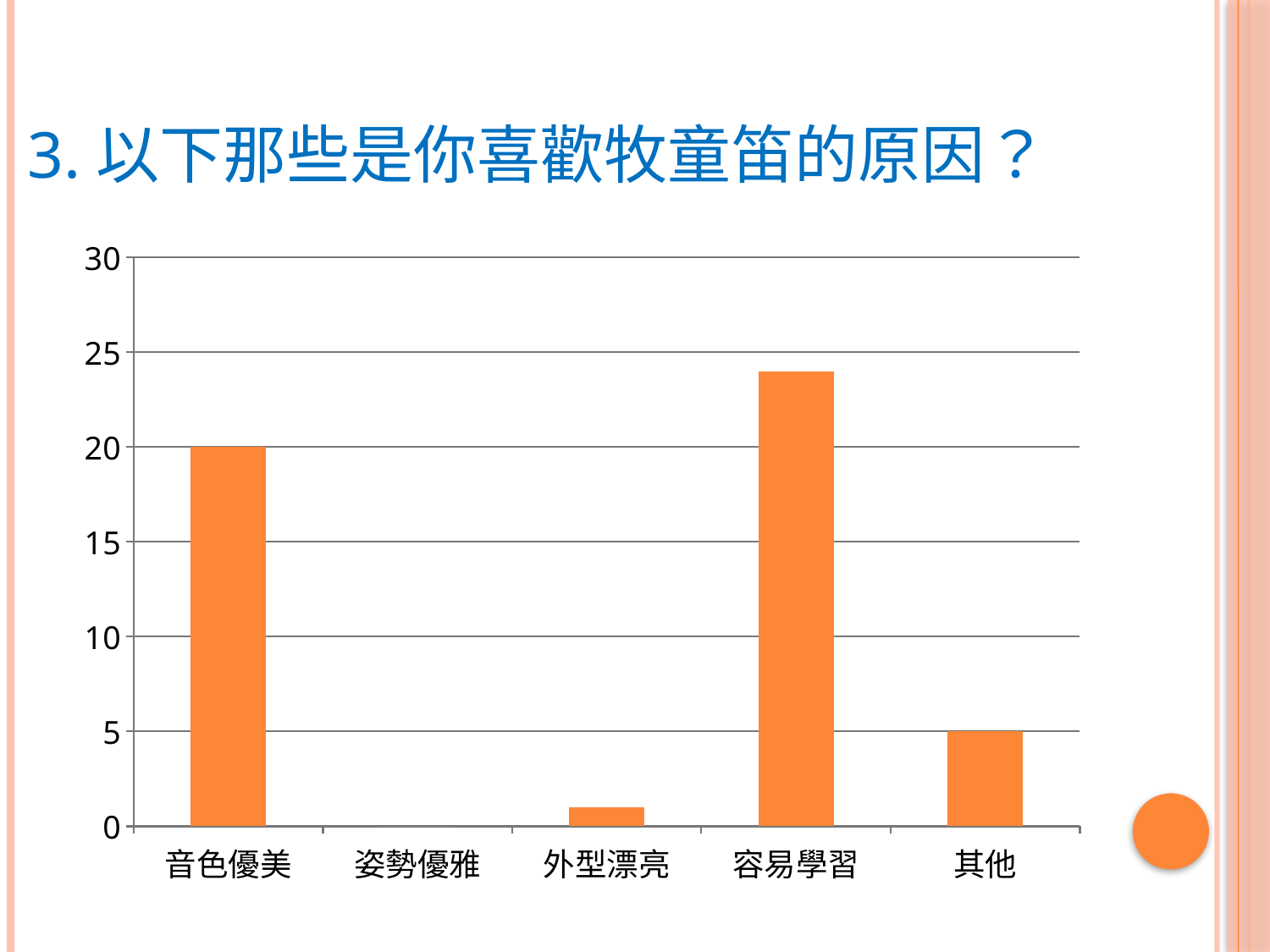
Which category has the highest value? 容易學習 Is the value for 外型漂亮 greater or less than 5? less Is the value for 容易學習 greater or less than 25? less What is the value for 音色優美? 20 Which category has the lowest value? 姿勢優雅 What is the difference between the values for 音色優美 and 其他? 15 How many categories are shown on the x axis? 5 Which is larger, the value for 音色優美 or the value for 其他? 音色優美 What is the value for 其他? 5 What is the value for 姿勢優雅? 0 What kind of chart is shown on the slide? bar chart Is the value for 容易學習 greater or less than 20? greater